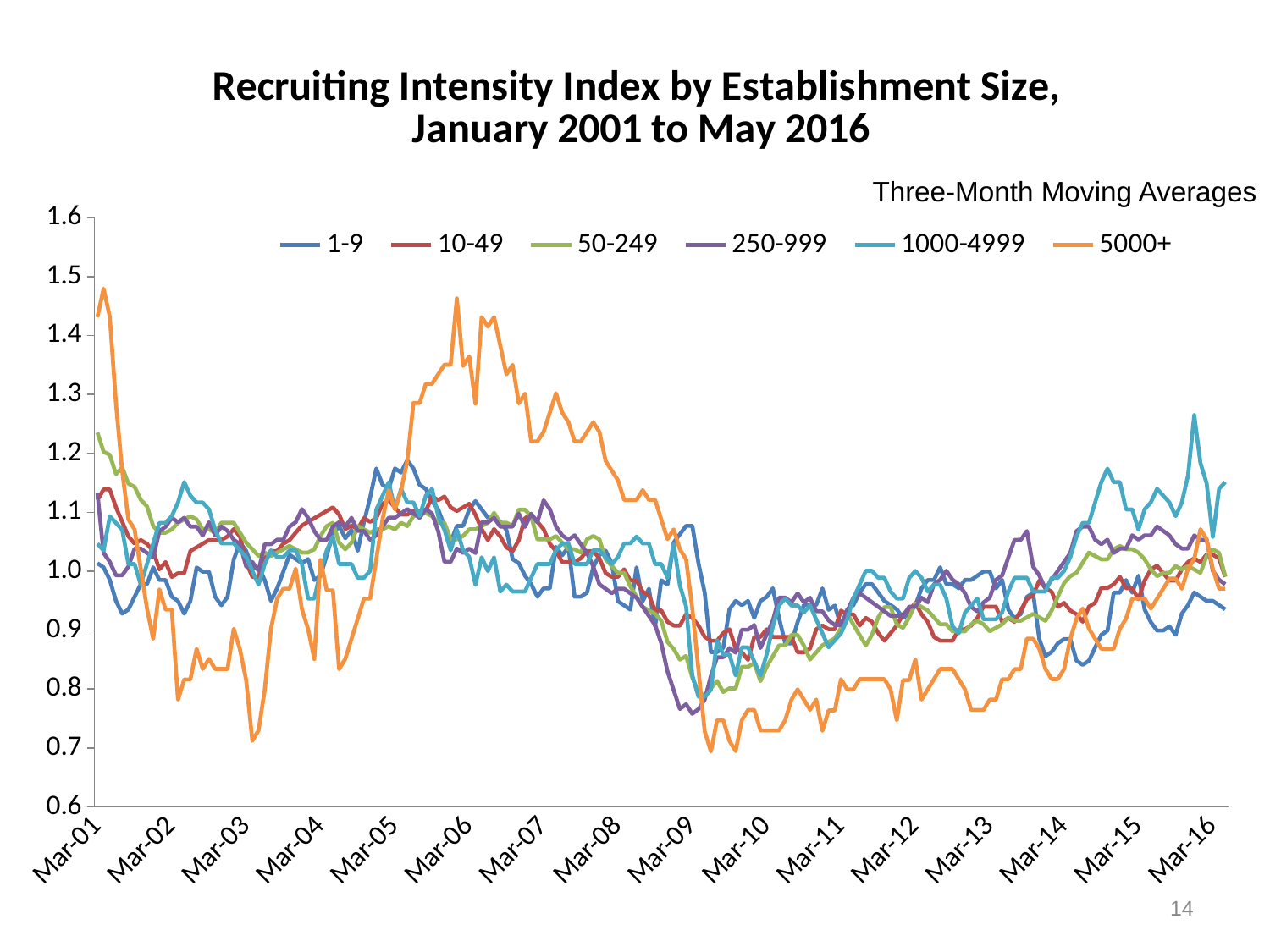
What kind of chart is shown on the slide? Line chart What note appears above the chart describing how the series are smoothed? Three-Month Moving Averages What is the title of the chart? Recruiting Intensity Index by Establishment Size, January 2001 to May 2016 Around Mar-10, which series is higher: 1-9 or 5000+? 1-9 Which series reaches the lowest value anywhere on the chart? 5000+ Is the value for the 1000-4999 series at its peak near Mar-16 greater or less than 1.2? greater How many labelled tick marks are shown on the x axis? 16 Does the 5000+ series rise or fall between Mar-06 and Mar-10? fall Which series reaches the highest value anywhere on the chart? 5000+ Is the value for the 5000+ series around Mar-10 greater or less than 0.8? less Is the value for the 5000+ series at its peak around Mar-06 greater or less than 1.3? greater How many series does the legend list? 6